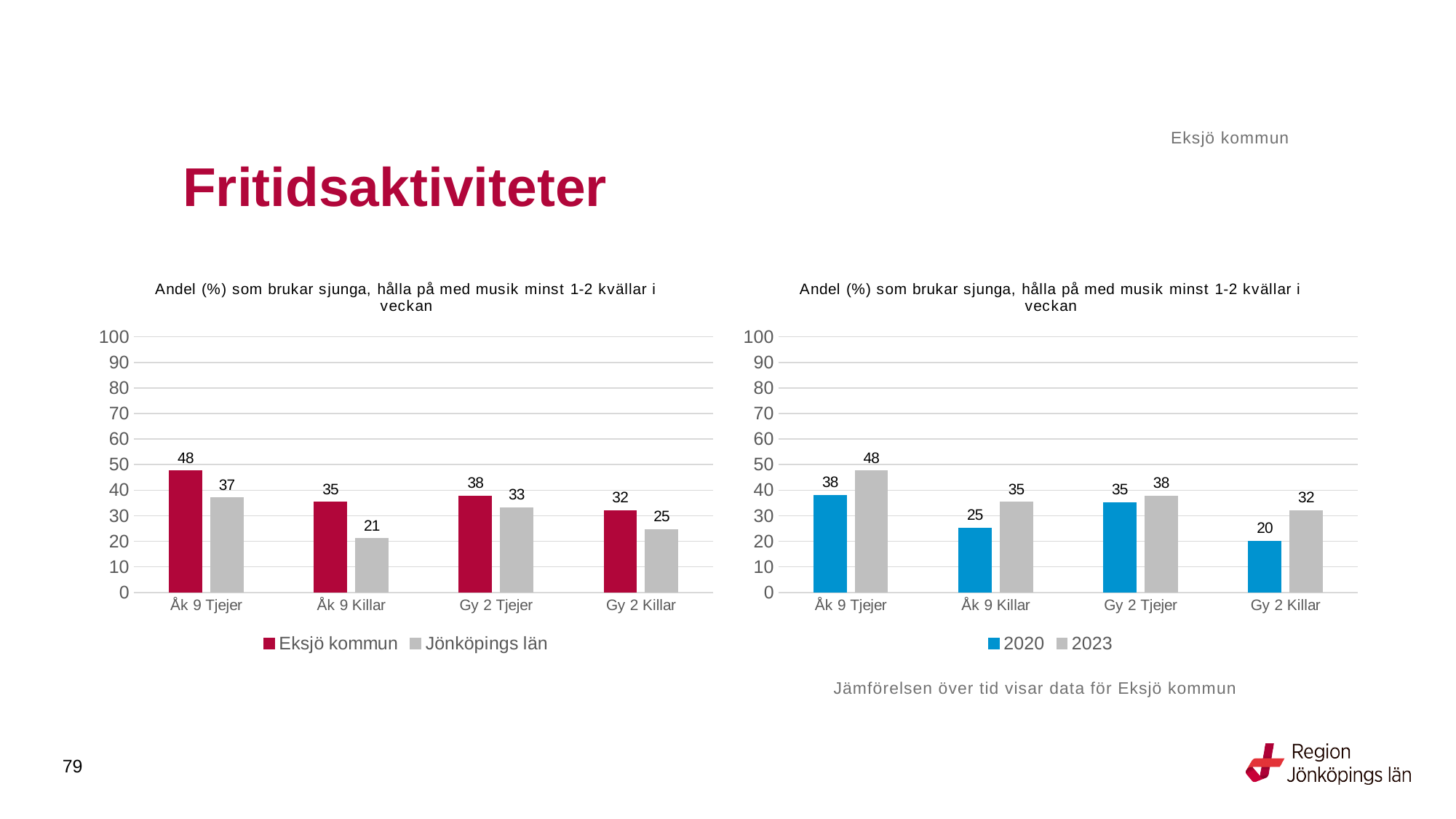
In the left chart, what is the value for Jönköpings län for Åk 9 Killar? 21 In the left chart, which category has the lowest value for Jönköpings län? Åk 9 Killar In the right chart, what is the value for 2023 for Åk 9 Tjejer? 48 In the left chart, how many series does the legend list? 2 In the left chart, which is larger for Gy 2 Tjejer: Eksjö kommun or Jönköpings län? Eksjö kommun In the right chart, which category has the highest value for 2020? Åk 9 Tjejer In the right chart, how many categories are shown on the x axis? 4 In the left chart, what is the value for Eksjö kommun for Åk 9 Tjejer? 48 In the right chart, what is the difference between 2023 and 2020 for Gy 2 Killar? 12 In the left chart, what is the difference between Eksjö kommun and Jönköpings län for Gy 2 Killar? 7 In the right chart, what is the value for 2020 for Gy 2 Killar? 20 What kind of chart is the right chart? Bar chart